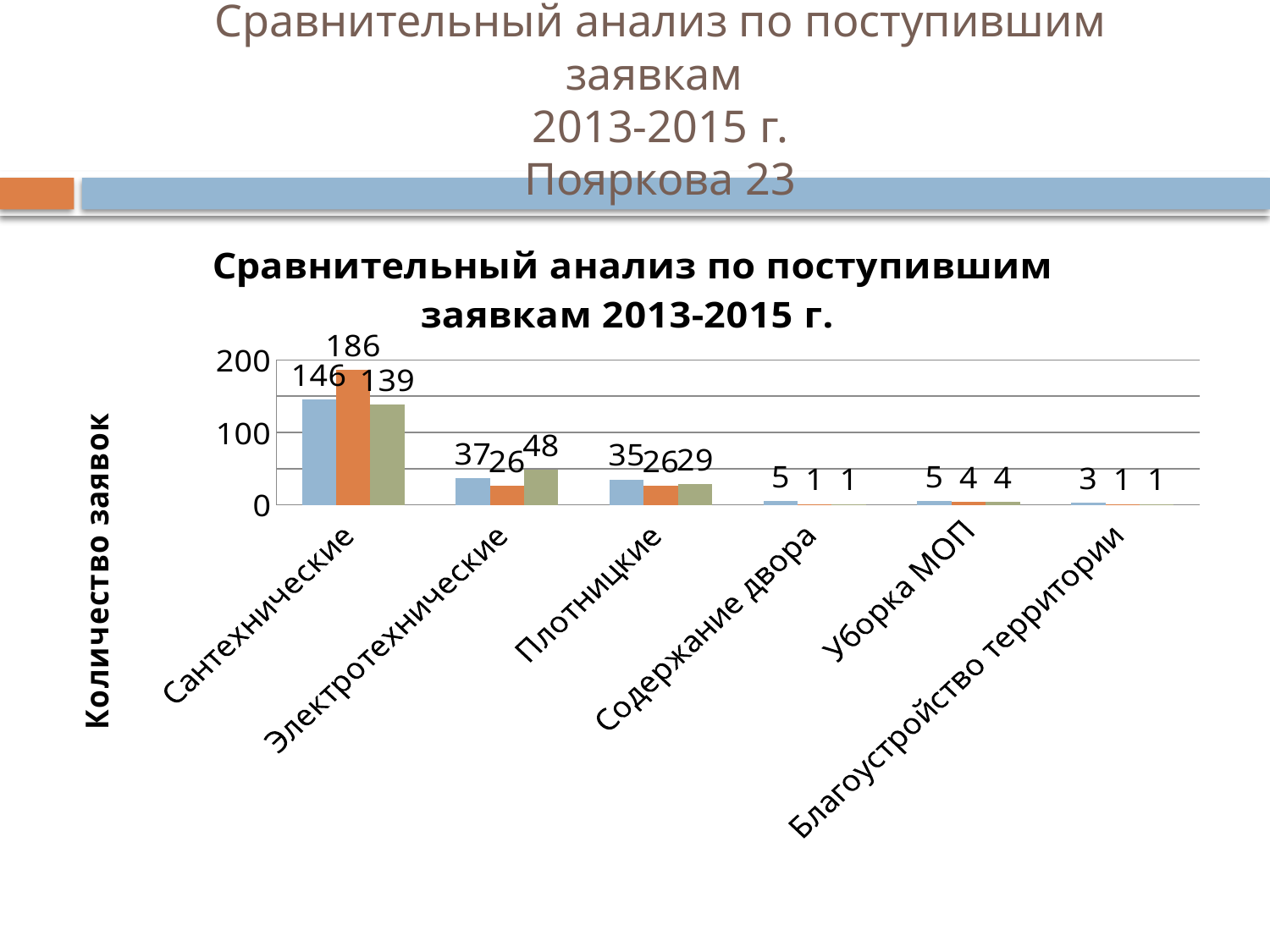
What type of chart is shown on the slide? bar chart What is the label of the vertical axis? Количество заявок What is the value of the blue (first) bar for Плотницкие? 35 What is the value of the orange (middle) bar for Сантехнические? 186 Which category has the lowest value for the blue (first) bar? Благоустройство территории How many bars are shown for each category? 3 What is the difference between the orange bar (186) and the green bar (139) for Сантехнические? 47 What is the difference between the blue bar and the orange bar for Электротехнические? 11 For Плотницкие, which is larger: the blue (first) bar or the green (third) bar? the blue (first) bar How many categories are shown on the x axis? 6 What is the value of the green (third) bar for Электротехнические? 48 Which category has the highest values overall? Сантехнические